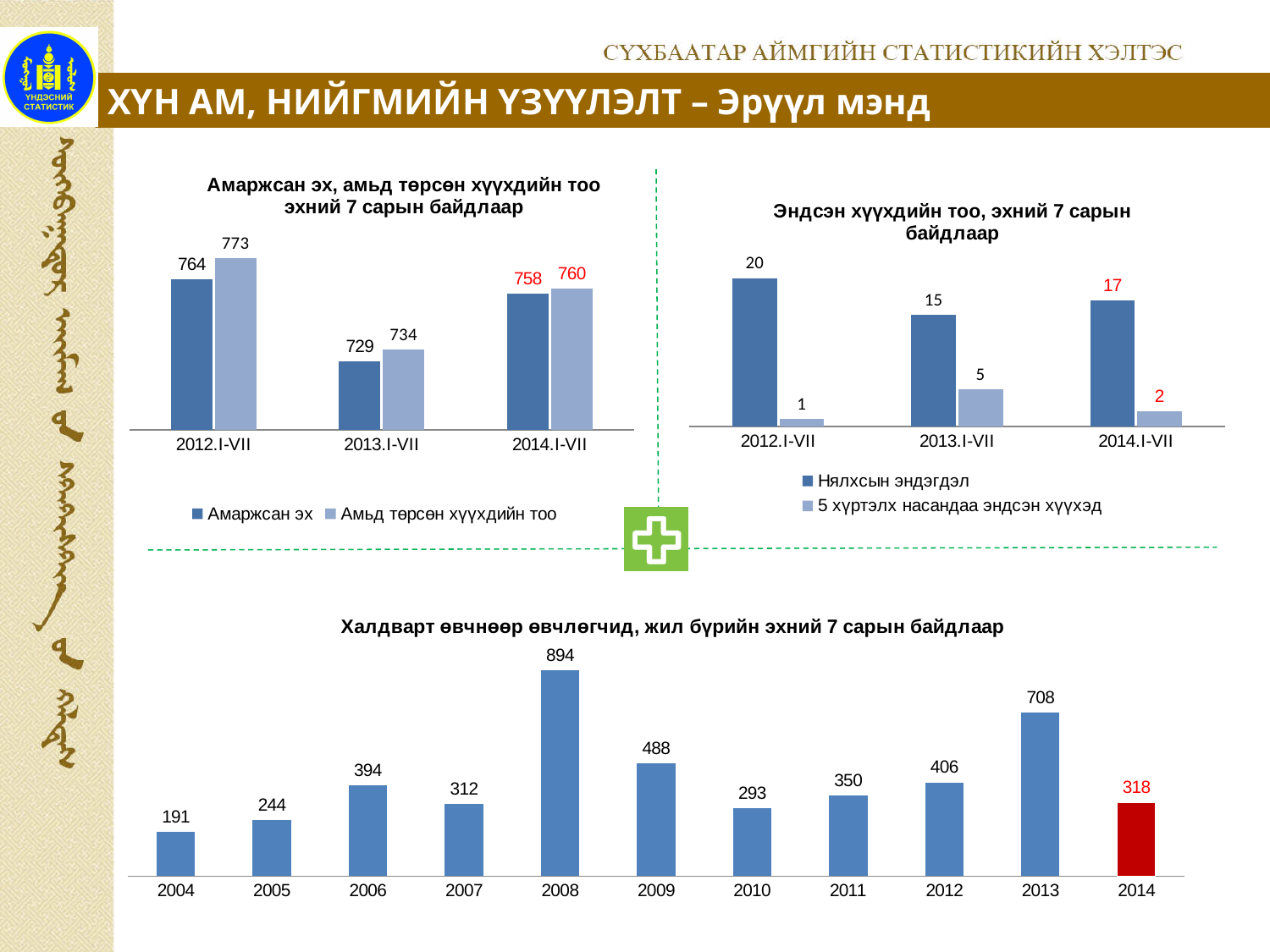
In the bottom chart (Халдварт өвчнөөр өвчлөгчид), which year has the lowest value? 2004 In the top-left chart (Амаржсан эх, амьд төрсөн хүүхдийн тоо), how many series does the legend list? 2 In the top-left chart (Амаржсан эх, амьд төрсөн хүүхдийн тоо), what is the value of Амаржсан эх for 2013.I-VII? 729 In the top-right chart (Эндсэн хүүхдийн тоо), which period has the highest value of 5 хүртэлх насандаа эндсэн хүүхэд? 2013.I-VII In the bottom chart (Халдварт өвчнөөр өвчлөгчид), what is the difference between 2013 and 2014? 390 In the bottom chart (Халдварт өвчнөөр өвчлөгчид), what is the value for 2008? 894 In the top-left chart (Амаржсан эх, амьд төрсөн хүүхдийн тоо), what is the value of Амьд төрсөн хүүхдийн тоо for 2012.I-VII? 773 In the top-right chart (Эндсэн хүүхдийн тоо), what is the value of Нялхсын эндэгдэл for 2014.I-VII? 17 In the top-right chart (Эндсэн хүүхдийн тоо), which period has the lowest value of Нялхсын эндэгдэл? 2013.I-VII In the bottom chart (Халдварт өвчнөөр өвчлөгчид), how many years are shown on the x axis? 11 In the top-left chart (Амаржсан эх, амьд төрсөн хүүхдийн тоо), what is the difference between Амьд төрсөн хүүхдийн тоо and Амаржсан эх in 2014.I-VII? 2 What type of chart is the bottom chart (Халдварт өвчнөөр өвчлөгчид)? Bar chart